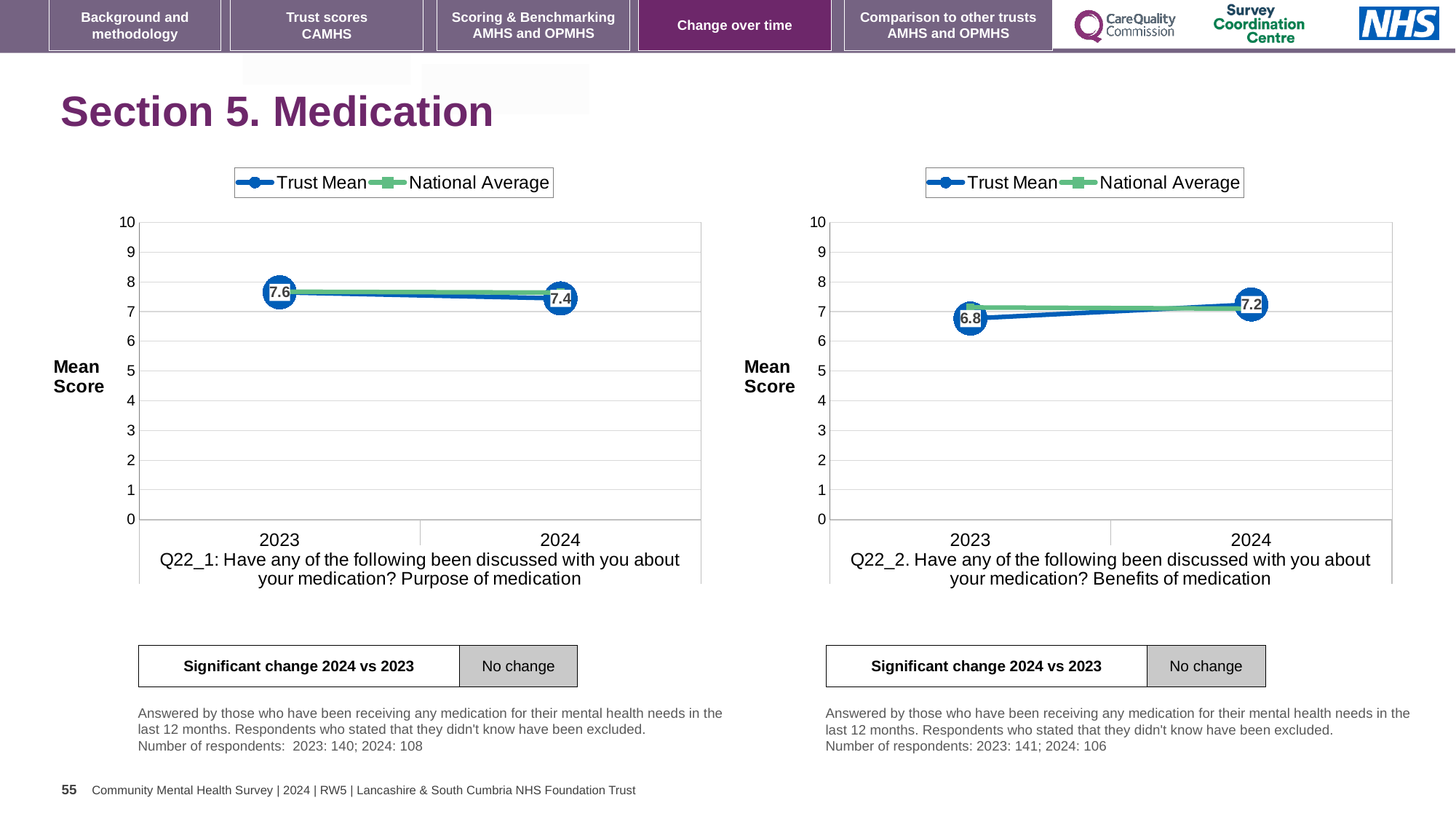
In the right chart (Q22_2: Benefits of medication), what is the Trust Mean score for 2023? 6.8 In the left chart (Q22_1: Purpose of medication), what is the Trust Mean score for 2023? 7.6 In the left chart (Q22_1: Purpose of medication), what is the Trust Mean score for 2024? 7.4 In the right chart (Q22_2: Benefits of medication), what is the Trust Mean score for 2024? 7.2 In the left chart (Q22_1: Purpose of medication), does the Trust Mean rise or fall from 2023 to 2024? fall In the right chart (Q22_2: Benefits of medication), does the Trust Mean rise or fall from 2023 to 2024? rise In the right chart (Q22_2: Benefits of medication), what is the difference between the Trust Mean for 2024 and 2023? 0.4 In the right chart (Q22_2: Benefits of medication), is the National Average value for 2023 greater or less than 5? greater In the left chart (Q22_1: Purpose of medication), by how much did the Trust Mean change from 2023 to 2024? 0.2 In the right chart (Q22_2: Benefits of medication), which year has the higher Trust Mean, 2023 or 2024? 2024 How many series does the legend of the right chart (Q22_2: Benefits of medication) list? 2 What kind of chart is the left chart (Q22_1: Purpose of medication)? line chart